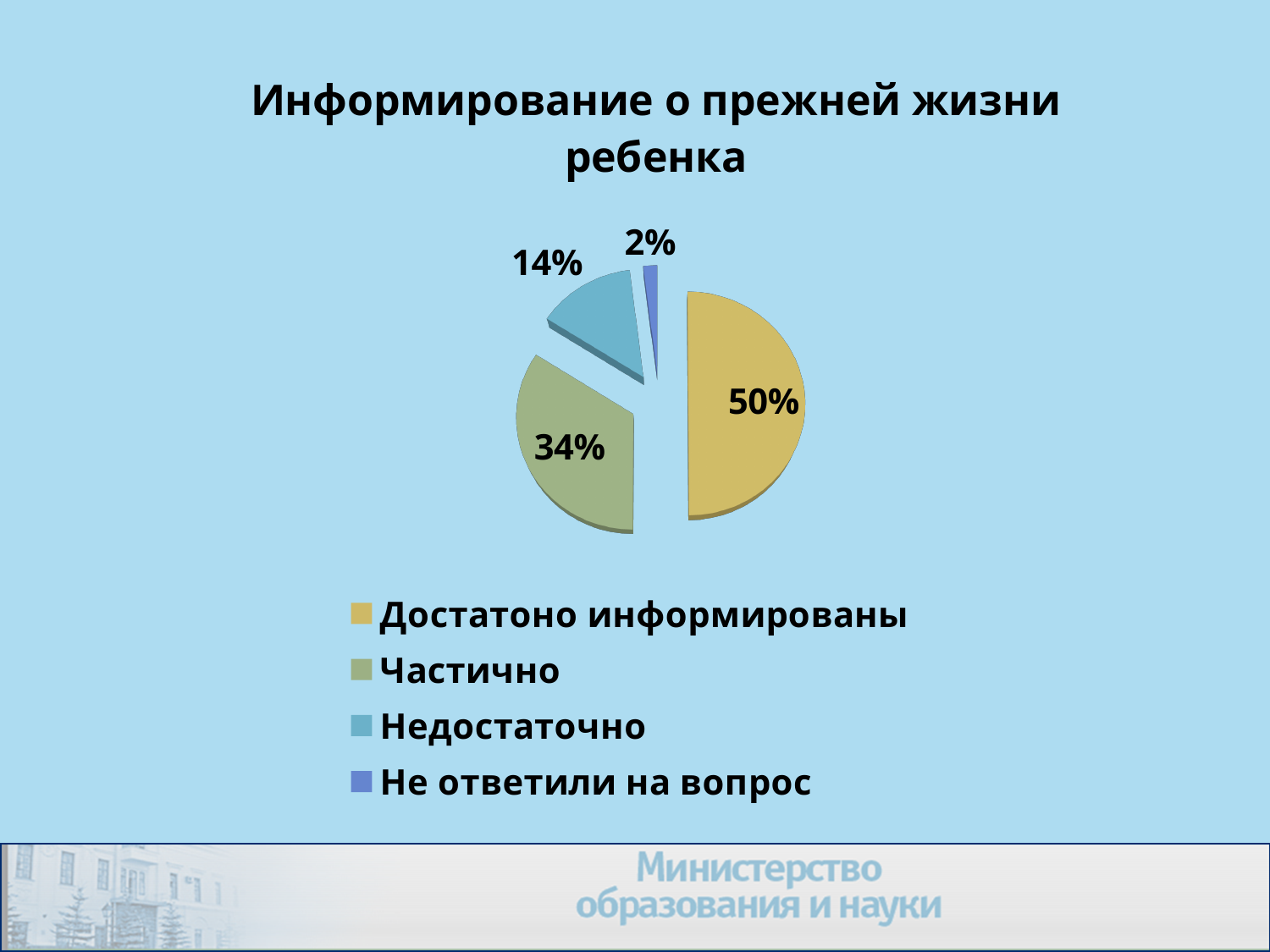
Which category has the smallest slice of the pie? Не ответили на вопрос Which is larger: the share for "Частично" or the share for "Недостаточно"? Частично What share of the pie is labelled "Недостаточно"? 14% How many slices does the pie chart have? 4 What share of the pie is labelled "Не ответили на вопрос"? 2% Which category has the largest slice of the pie? Достатоно информированы How many entries does the legend list? 4 What is the title of the chart? Информирование о прежней жизни ребенка What kind of chart is shown on the slide? pie chart What share of the pie is labelled "Частично"? 34% What share of the pie is labelled "Достатоно информированы"? 50% What is the difference between the shares for "Достатоно информированы" and "Частично"? 16%